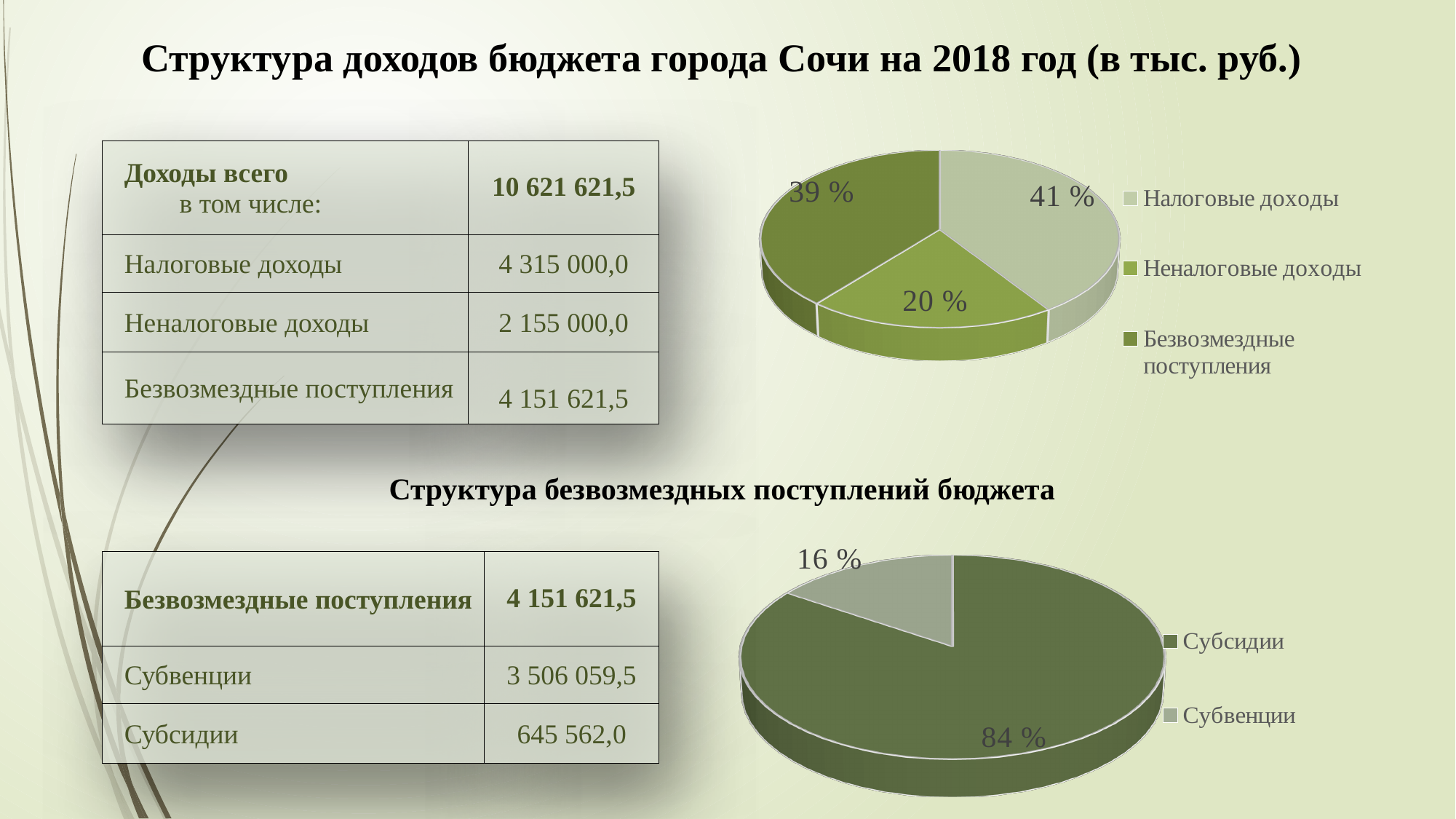
In the top pie chart, what is the difference in percentage points between the Налоговые доходы slice and the Неналоговые доходы slice? 21 In the bottom pie chart, which category does the legend assign to the dark green colour? Субсидии In the bottom pie chart, what percentage is printed on the small light slice? 16 % In the top pie chart, what share is shown for Неналоговые доходы? 20 % In the top pie chart, what share is shown for Безвозмездные поступления? 39 % In the top pie chart, which category has the largest share? Налоговые доходы In the top pie chart, which category has the smallest share? Неналоговые доходы In the top pie chart, how many categories does the legend list? 3 In the bottom pie chart (Структура безвозмездных поступлений бюджета), how many slices are there? 2 What type of chart is shown at the top right of the slide? pie chart